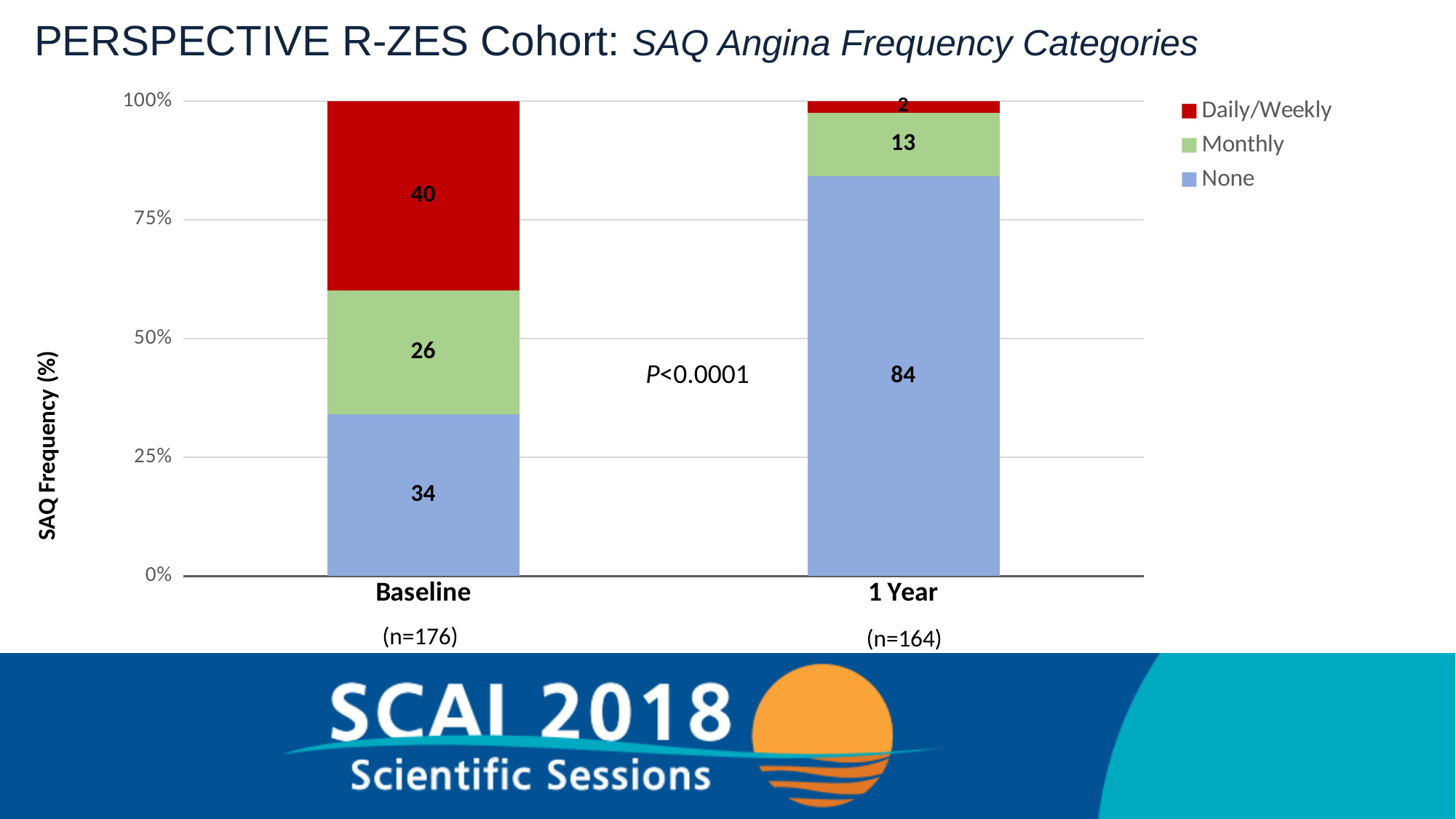
What kind of chart is this? Stacked bar chart What is the value for None at 1 Year? 84 Which category has the smallest value at 1 Year? Daily/Weekly What is the value for Monthly at Baseline? 26 Which is larger: Monthly at Baseline or Monthly at 1 Year? Monthly at Baseline How many categories are shown on the x axis? 2 What is the value for Daily/Weekly at 1 Year? 2 What is the difference between the None value at 1 Year and at Baseline? 50 Which category has the largest value at Baseline? Daily/Weekly What is the value for None at Baseline? 34 What is the sample size shown for the 1 Year group? n=164 How many series does the legend list? 3